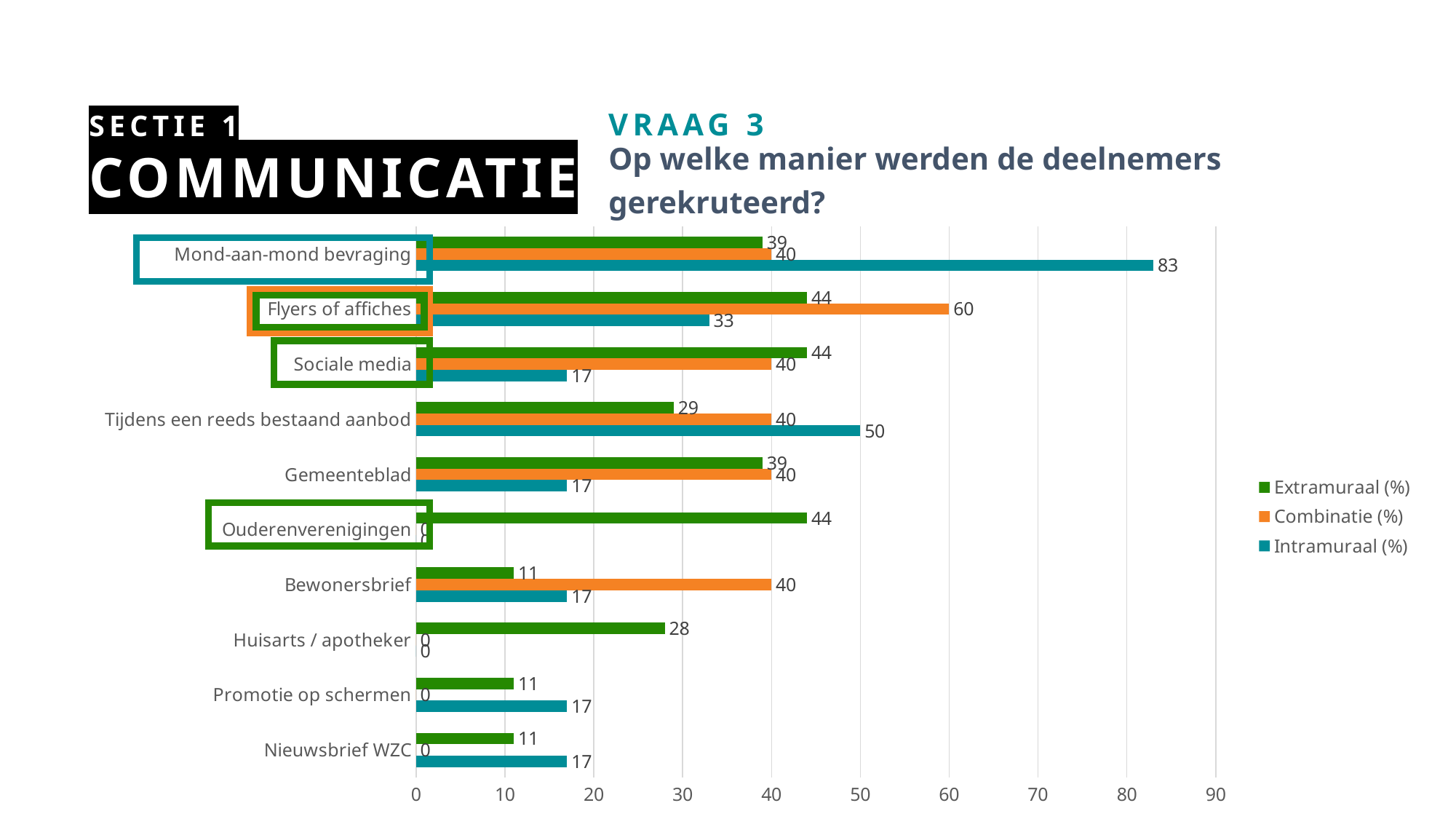
What is the Intramuraal (%) value for Mond-aan-mond bevraging? 83 What is the Combinatie (%) value for Flyers of affiches? 60 Is the Combinatie (%) value for Flyers of affiches greater or less than 50? greater Which series is shown in orange in the legend? Combinatie (%) What is the Extramuraal (%) value for Huisarts / apotheker? 28 For Tijdens een reeds bestaand aanbod, which is larger: the Intramuraal (%) value or the Extramuraal (%) value? Intramuraal (%) How many series does the legend list? 3 How many categories are shown on the chart? 10 What type of chart is shown on the slide? bar chart Which category has the highest Intramuraal (%) value? Mond-aan-mond bevraging Which category has the lowest Extramuraal (%) value? Bewonersbrief, Promotie op schermen and Nieuwsbrief WZC (all 11) What is the difference between the Intramuraal (%) and Extramuraal (%) values for Mond-aan-mond bevraging? 44